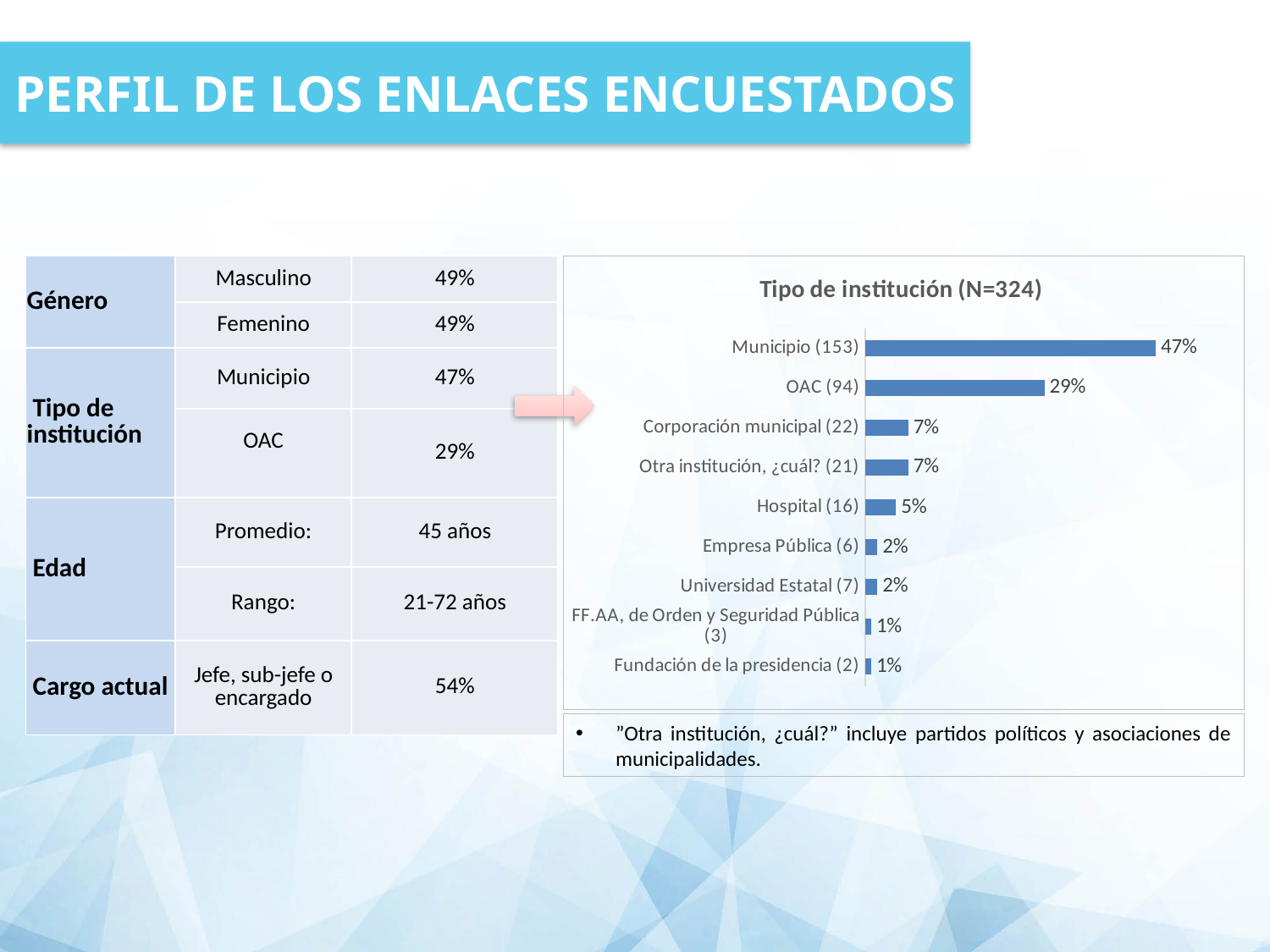
What is the title of the chart? Tipo de institución (N=324) What type of chart is shown on the slide? Bar chart What is the difference in percentage points between OAC (94) and Hospital (16)? 24% How many institution categories are shown in the chart? 9 What percentage is shown for Hospital (16) in the chart? 5% What percentage is shown for Corporación municipal (22) in the chart? 7% What is the difference in percentage points between Municipio (153) and OAC (94)? 18% Which institution type has the highest percentage in the chart? Municipio (153) What percentage is shown for Fundación de la presidencia (2) in the chart? 1% What percentage is shown for Municipio (153) in the chart? 47% Which has a larger percentage in the chart, Hospital (16) or Empresa Pública (6)? Hospital (16) What percentage is shown for OAC (94) in the chart? 29%